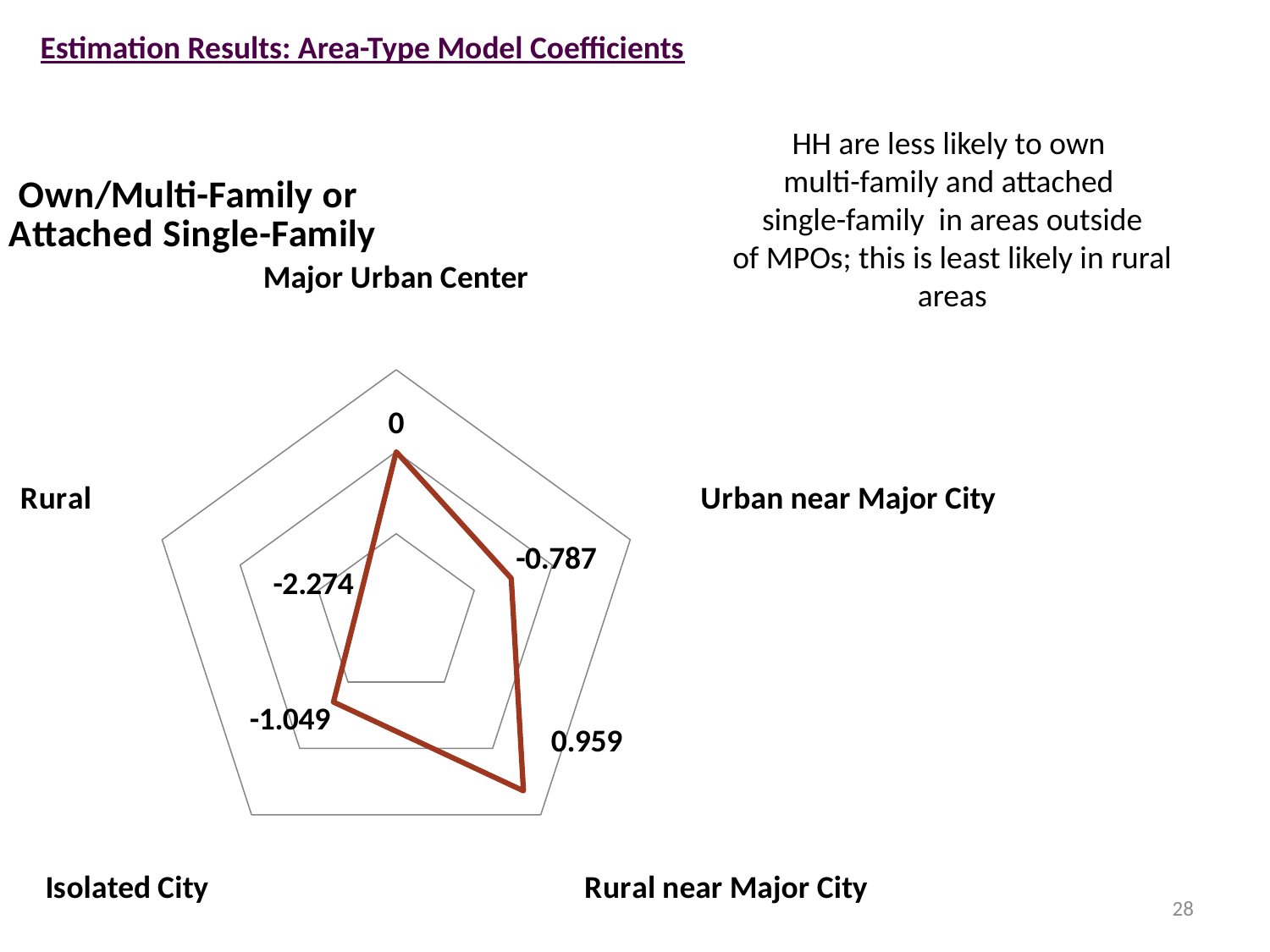
How many area-type categories are plotted on the chart? 5 What is the coefficient value for Isolated City? -1.049 What is the coefficient value for Major Urban Center? 0 What is the coefficient value for Rural in the radar chart? -2.274 Which area type has the highest coefficient in the chart? Rural near Major City What is the title of the chart? Own/Multi-Family or Attached Single-Family Which has a larger coefficient, Isolated City or Urban near Major City? Urban near Major City What is the difference between the coefficients for Rural near Major City and Urban near Major City? 1.746 What is the coefficient value for Rural near Major City? 0.959 What is the coefficient value for Urban near Major City? -0.787 What kind of chart is shown on the slide? Radar chart Which area type has the lowest coefficient in the chart? Rural